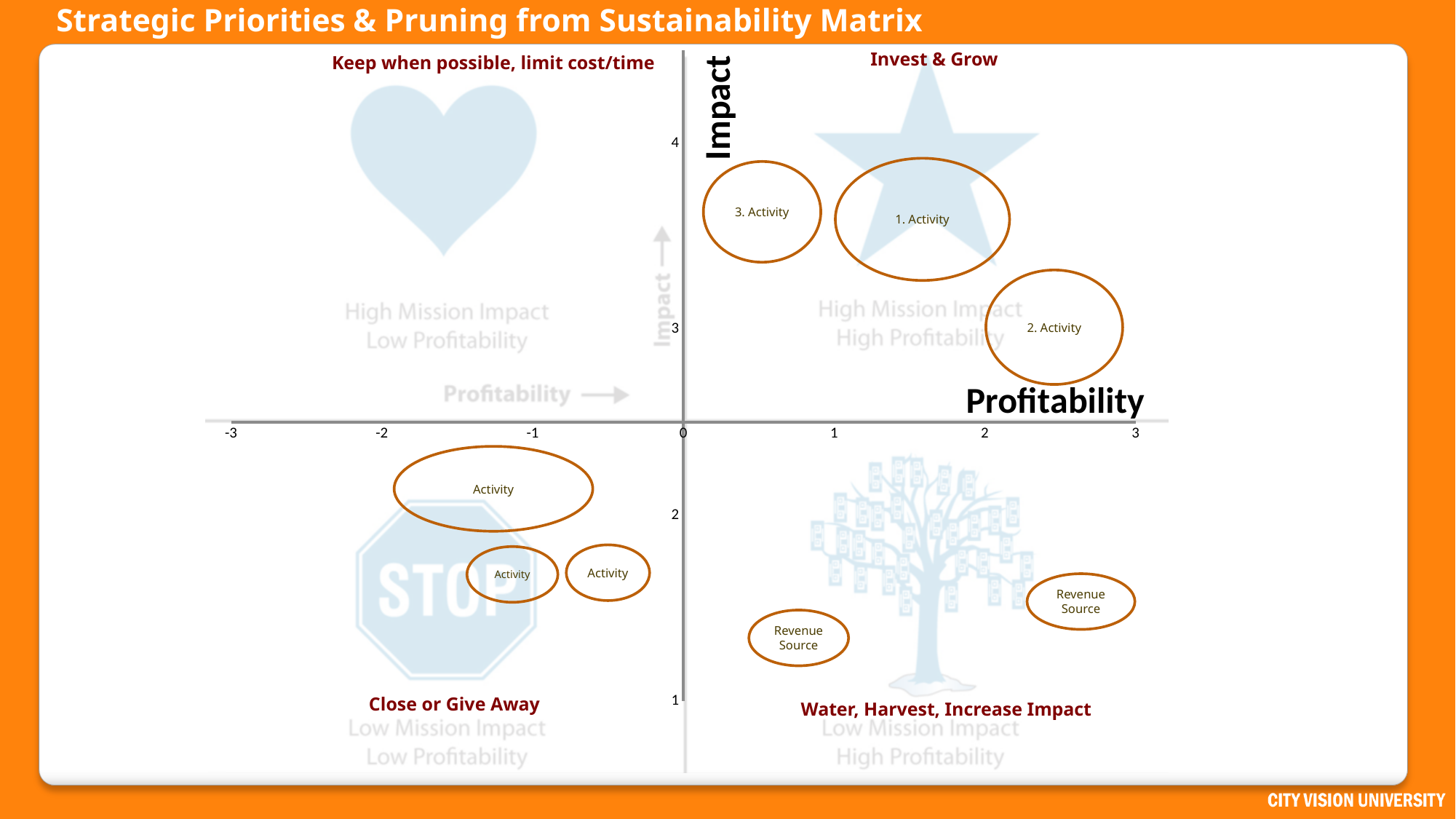
How many ellipses (data points) are plotted on the matrix? 8 How many ellipses are labelled "Revenue Source"? 2 Which labelled ellipse has the highest Profitability value? Revenue Source Which has the higher Profitability value, "2. Activity" or "3. Activity"? 2. Activity What kind of chart is shown on the slide? bubble chart What is the label of the horizontal axis of the matrix? Profitability Is the Profitability value for "2. Activity" greater or less than 2? greater Is the Impact value for "1. Activity" greater or less than 3? greater Which has the higher Impact value, "1. Activity" or "2. Activity"? 1. Activity How many ellipses are plotted in the "Invest & Grow" quadrant? 3 Is the Impact value for the right-hand "Revenue Source" ellipse greater or less than 2? less